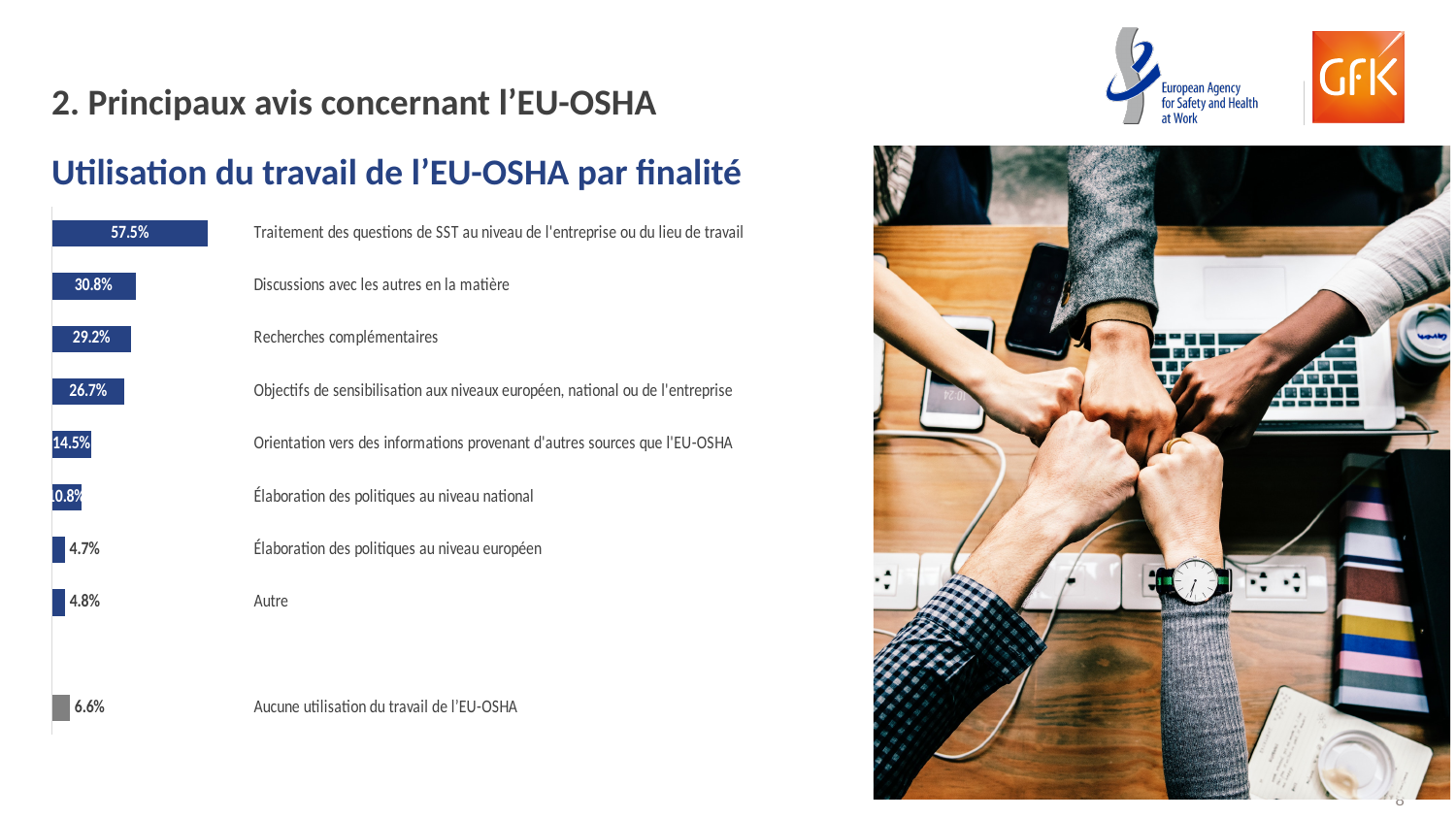
Which category has the highest value? Traitement des questions de SST au niveau de l'entreprise ou du lieu de travail What is the difference between the values for "Discussions avec les autres en la matière" and "Recherches complémentaires"? 1.6% What is the value for "Élaboration des politiques au niveau national"? 10.8% Which category has the lowest value? Élaboration des politiques au niveau européen What is the value for "Aucune utilisation du travail de l'EU-OSHA"? 6.6% What is the title of the chart? Utilisation du travail de l'EU-OSHA par finalité What type of chart is shown on the slide? bar chart What is the value for "Discussions avec les autres en la matière"? 30.8% What is the value for "Traitement des questions de SST au niveau de l'entreprise ou du lieu de travail"? 57.5% How many categories are shown in the chart? 9 What is the value for "Recherches complémentaires"? 29.2% Which is larger: the value for "Objectifs de sensibilisation aux niveaux européen, national ou de l'entreprise" or the value for "Orientation vers des informations provenant d'autres sources que l'EU-OSHA"? Objectifs de sensibilisation aux niveaux européen, national ou de l'entreprise